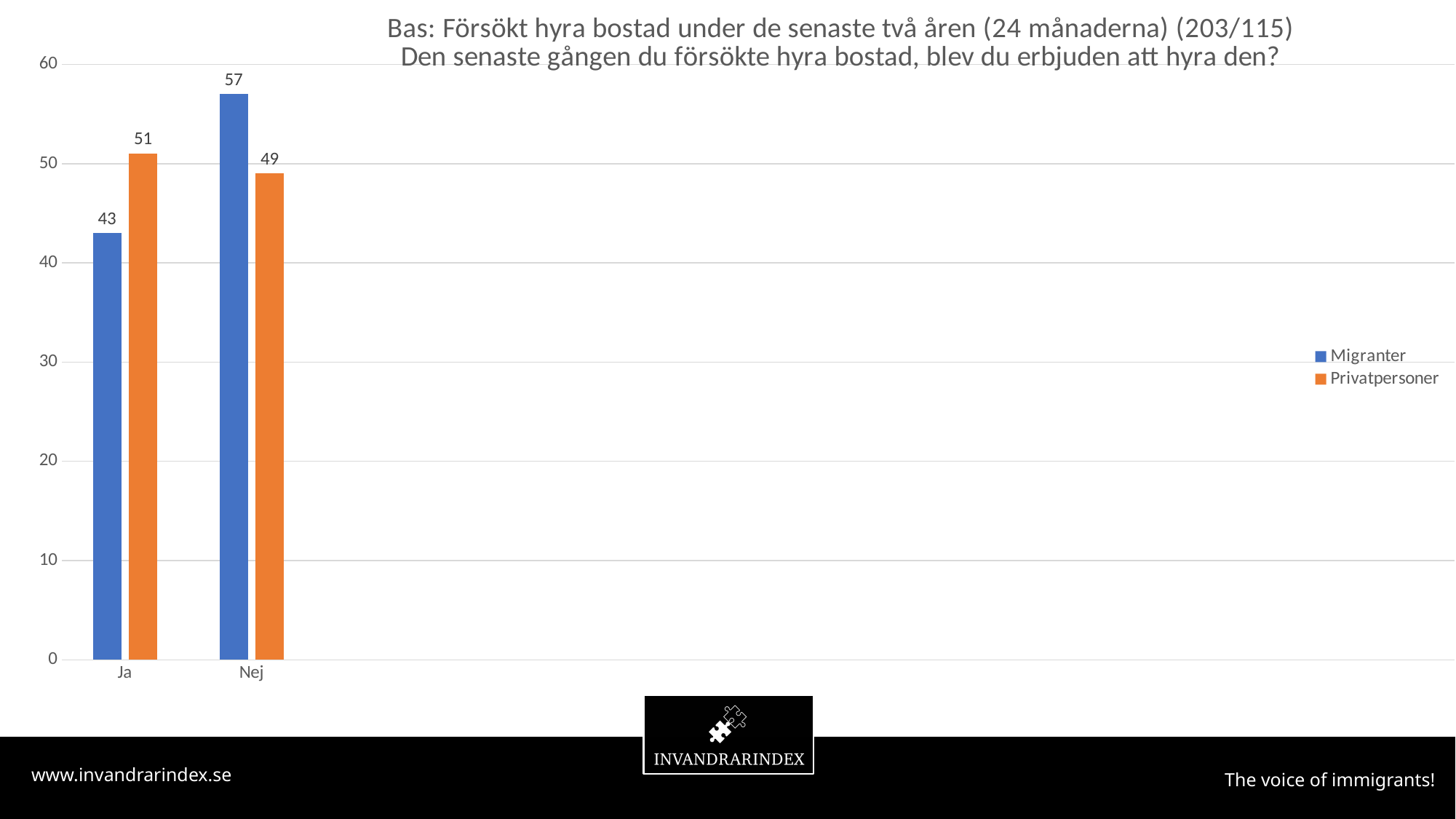
Which category has the lowest value for Privatpersoner? Nej What is the value for Migranter in the Nej category? 57 What is the value for Migranter in the Ja category? 43 What kind of chart is shown on the slide? Bar chart What is the value for Privatpersoner in the Nej category? 49 Which colour represents the Privatpersoner series? Orange How many series does the legend list? 2 What is the difference between the Migranter and Privatpersoner values in the Nej category? 8 Which category has the highest value for Migranter? Nej In the Ja category, which series has the larger value, Migranter or Privatpersoner? Privatpersoner How many categories are shown on the x axis? 2 What is the value for Privatpersoner in the Ja category? 51